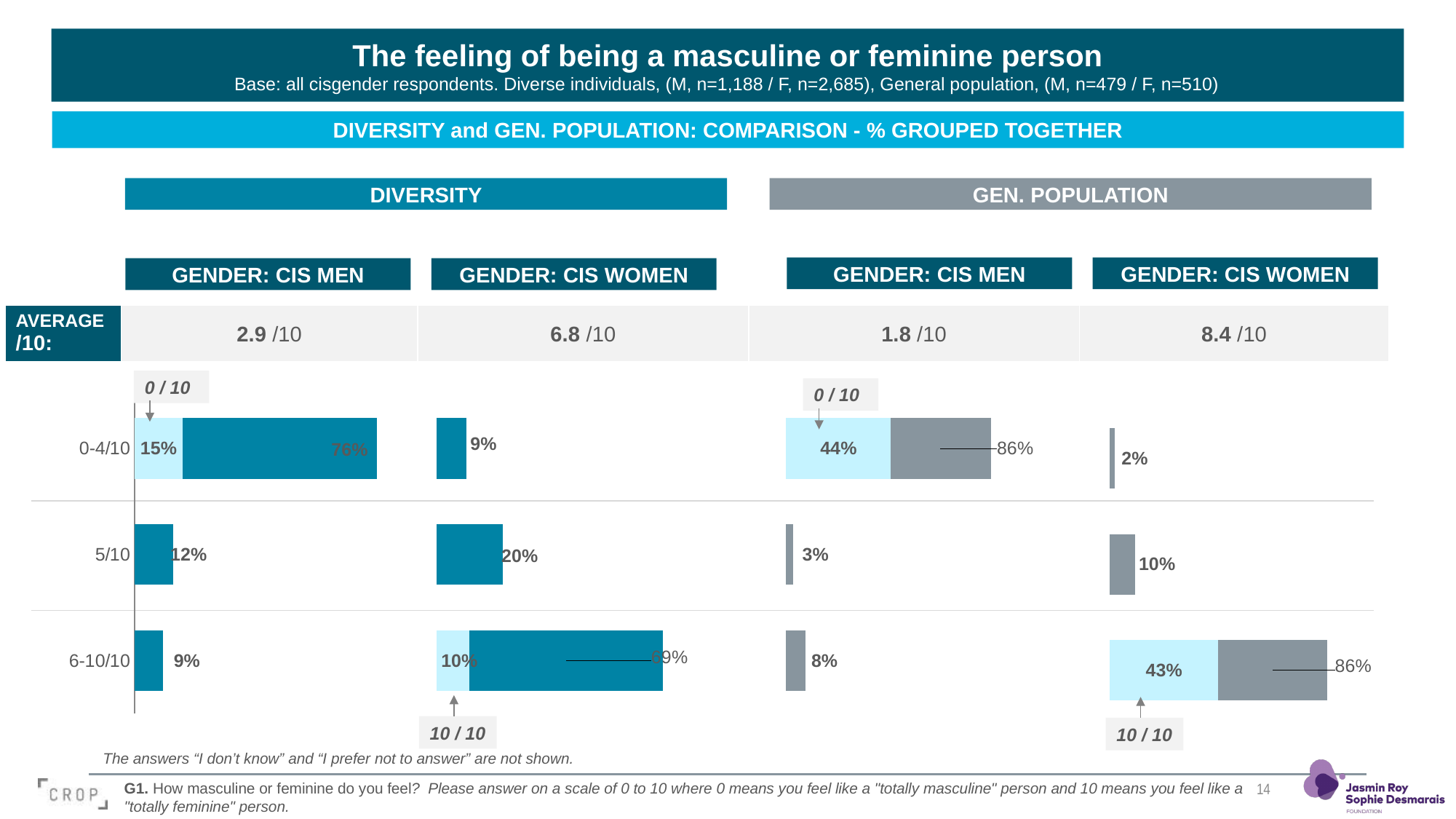
What type of chart is used to show the percentages on this slide? Bar chart In the Gen. Population Cis Women chart, what percentage answered 10/10? 43% How many score categories are shown in each chart? 3 Which is larger: the 5/10 percentage for Diversity Cis Women or the 5/10 percentage for Gen. Population Cis Women? Diversity Cis Women In the Diversity Cis Men chart, what is the difference between the 0-4/10 and 6-10/10 percentages? 67% What is the average score out of 10 shown for Gen. Population Cis Women? 8.4 /10 In the Diversity Cis Women chart, which category has the highest percentage? 6-10/10 In the Gen. Population Cis Men chart, what percentage is shown for the 5/10 category? 3% In the Gen. Population Cis Women chart, which category has the lowest percentage? 0-4/10 In the Diversity Cis Women chart, what percentage is shown for the 6-10/10 category? 69% In the Gen. Population Cis Men chart, what percentage answered 0/10? 44% In the Diversity Cis Men chart, what percentage is shown for the 0-4/10 category? 76%